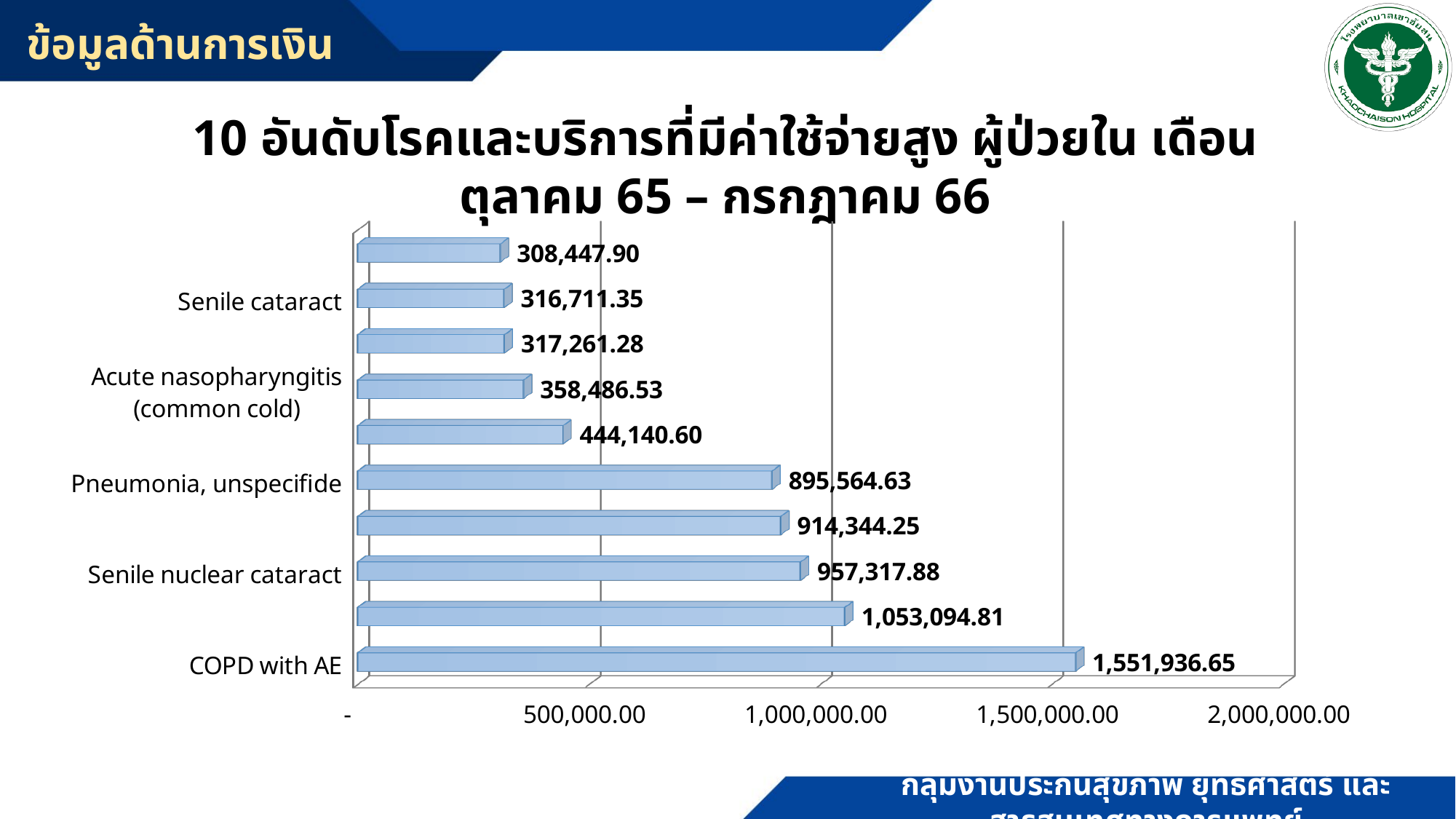
What type of chart is shown on the slide? bar chart What is the value for Senile nuclear cataract? 957,317.88 Which is larger, the value for Acute nasopharyngitis (common cold) or the value for Senile cataract? Acute nasopharyngitis (common cold) What is the value for Senile cataract? 316,711.35 What is the value for COPD with AE? 1,551,936.65 What is the difference between the values for COPD with AE and Senile nuclear cataract? 594,618.77 Is the value for Pneumonia, unspecifide greater or less than 1,000,000.00? less What is the value for Acute nasopharyngitis (common cold)? 358,486.53 Which category has the highest value? COPD with AE What is the smallest value shown on the chart? 308,447.90 What is the value for Pneumonia, unspecifide? 895,564.63 How many bars are plotted on the chart? 10